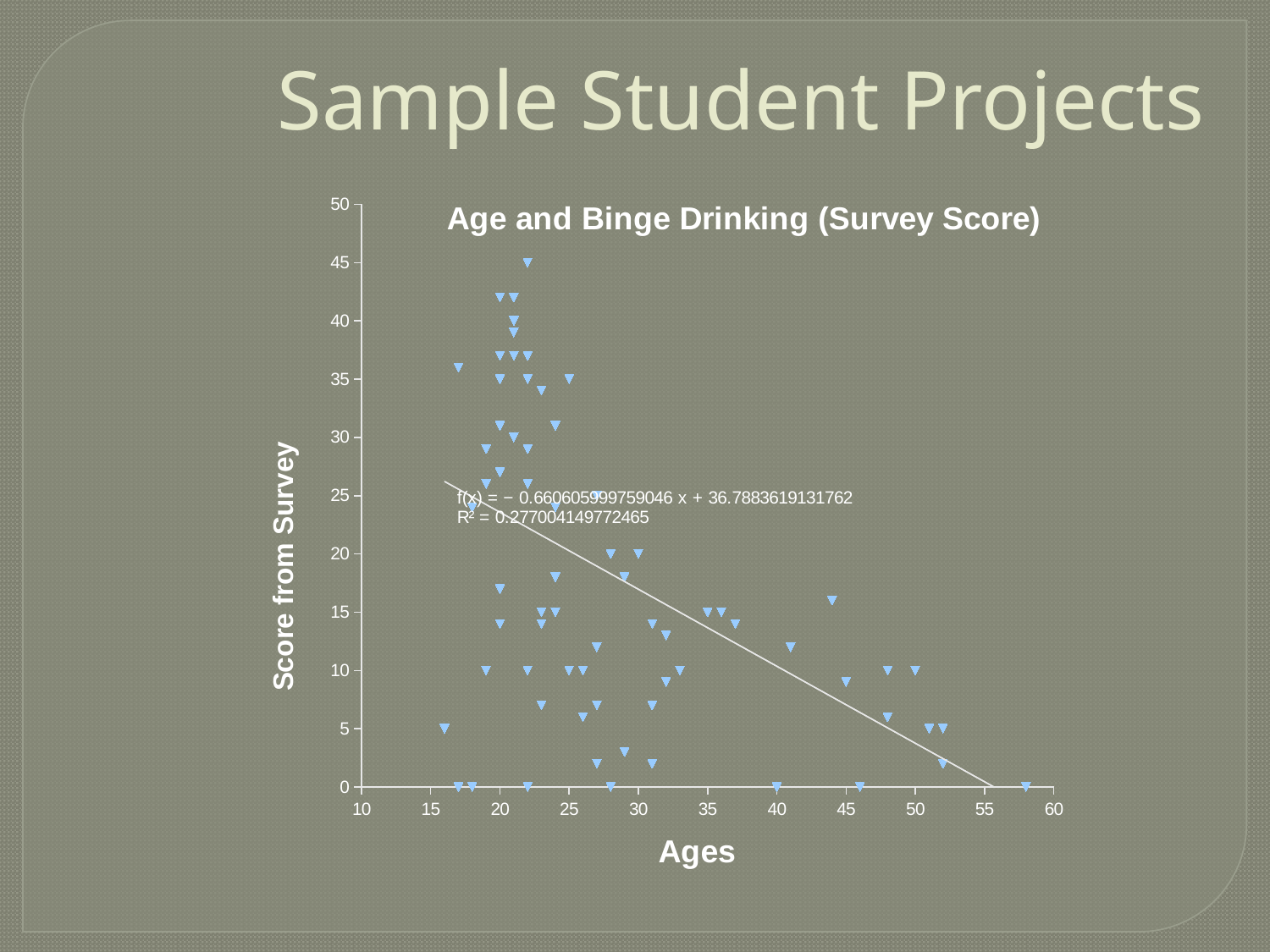
What R² value is printed on the chart? R² = 0.277004149772465 What is the intercept of the fitted line f(x) printed on the chart? 36.7883619131762 What are the titles of the x axis and the y axis of the chart? Ages (x axis) and Score from Survey (y axis) Is the value of the trendline at age 50 greater or less than 10? less Is the age of the rightmost plotted point greater or less than 55? greater Is the value of the trendline at age 20 greater or less than 20? greater What is the title of the chart? Age and Binge Drinking (Survey Score) What is the slope of the fitted line f(x) printed on the chart? −0.660605999759046 What kind of chart is shown on the slide? Scatter chart According to the trendline, do survey scores rise or fall as age increases? Fall